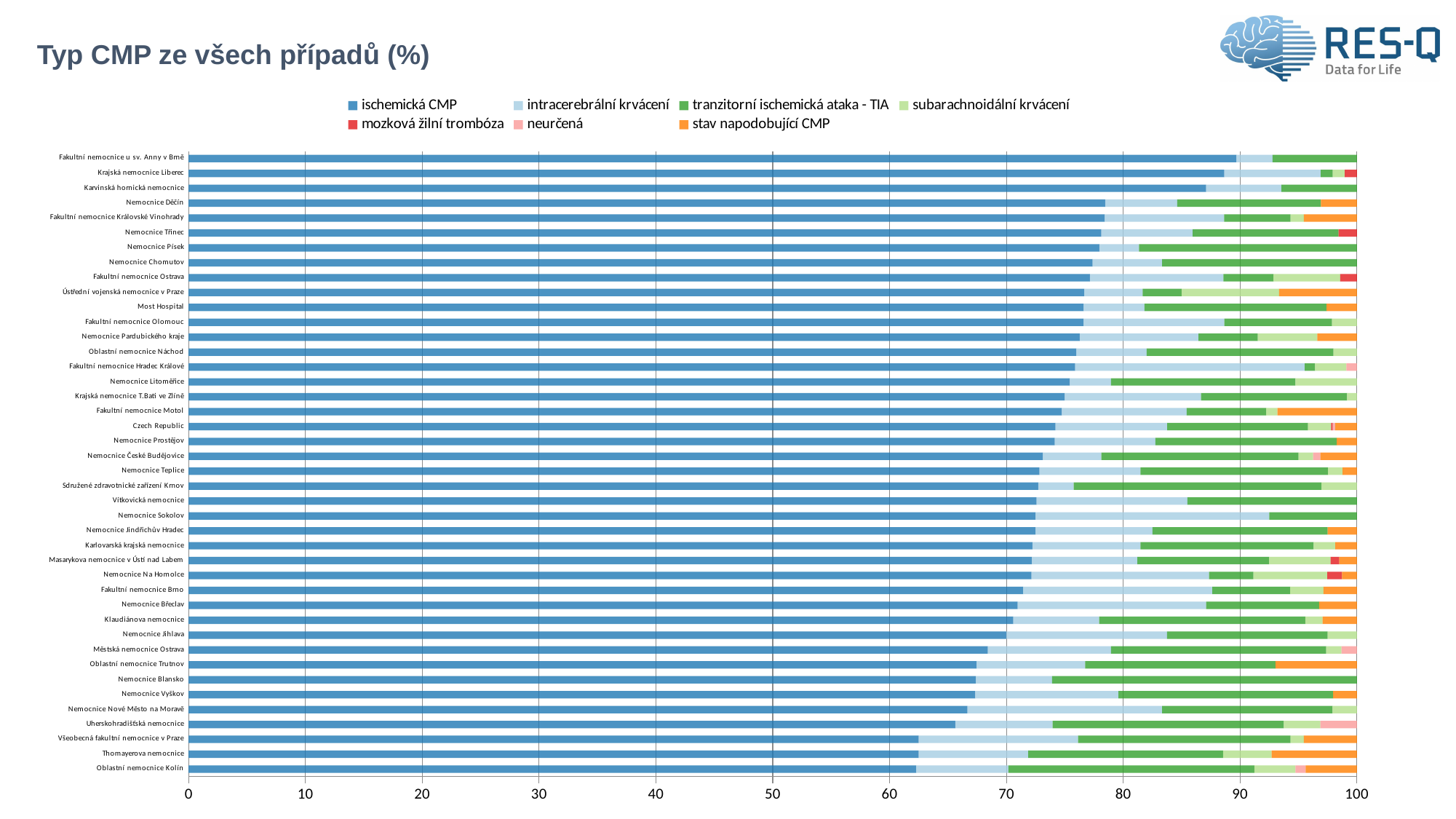
What is the title of the chart? Typ CMP ze všech případů (%) What kind of chart is shown on the slide? bar chart Is the ischemická CMP share for Fakultní nemocnice u sv. Anny v Brně greater or less than 80? greater How many series does the legend list? 7 Which series is shown in orange in the legend? stav napodobující CMP Which category has the highest share of ischemická CMP? Fakultní nemocnice u sv. Anny v Brně Is the ischemická CMP share for Nemocnice Blansko greater or less than 70? less Which has a larger ischemická CMP share, Nemocnice Děčín or Nemocnice Blansko? Nemocnice Děčín How many hospitals/categories are plotted on the chart? 42 Which has a larger ischemická CMP share, Krajská nemocnice Liberec or Thomayerova nemocnice? Krajská nemocnice Liberec Is the ischemická CMP share for Oblastní nemocnice Kolín greater or less than 70? less